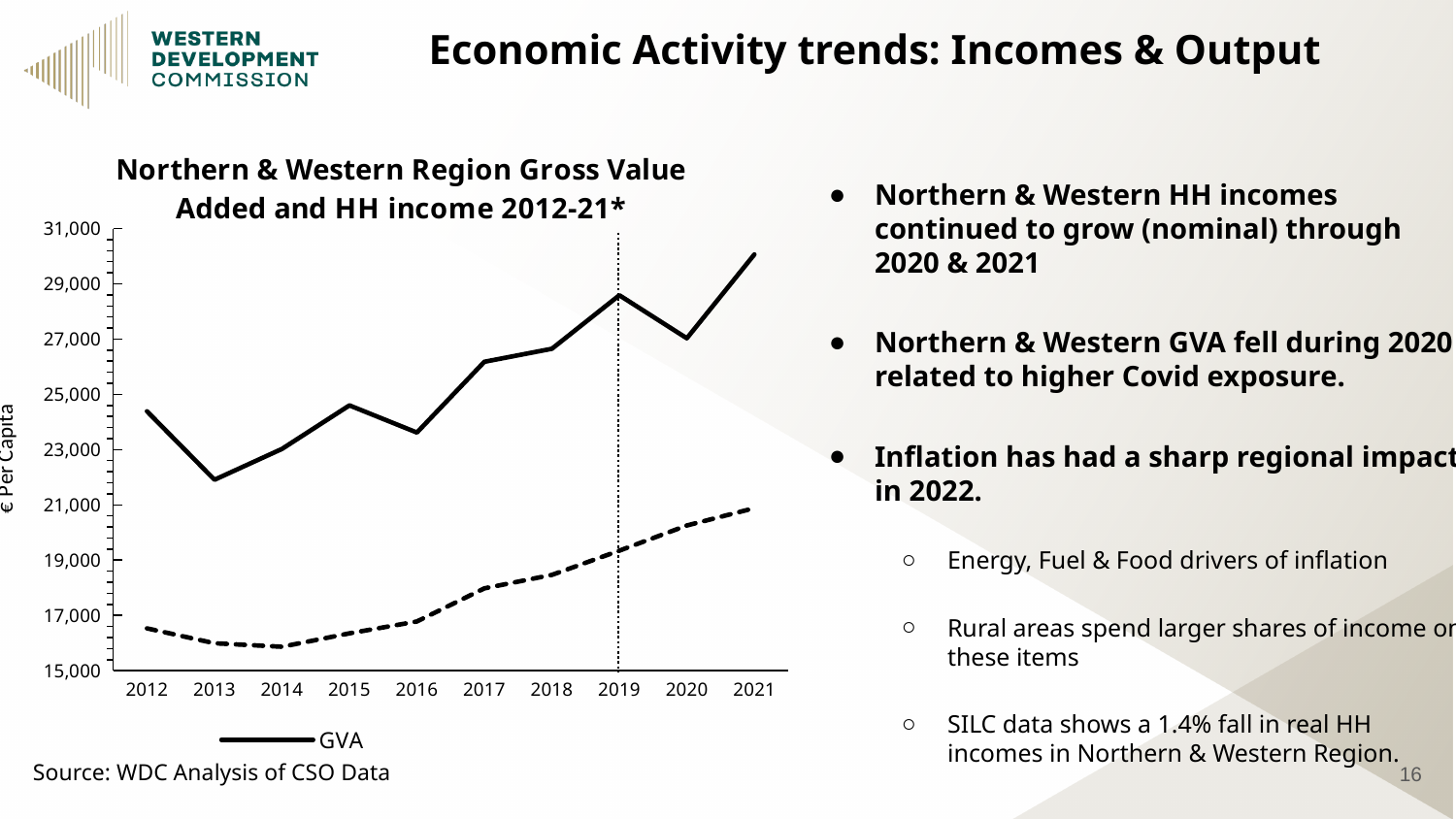
How many years are plotted along the x axis of the chart? 10 Is the GVA value for 2012 greater or less than 23,000? greater Does the dashed line generally rise or fall between 2014 and 2021? rise Is the GVA value for 2021 greater or less than 29,000? greater Is the value of the dashed line for 2012 greater or less than 17,000? less What is the label on the vertical axis of the chart? € Per Capita Which year has the higher GVA value, 2019 or 2020? 2019 In which year is the GVA line at its lowest? 2013 In which year is the GVA line at its highest? 2021 What kind of chart is shown on the slide? line chart